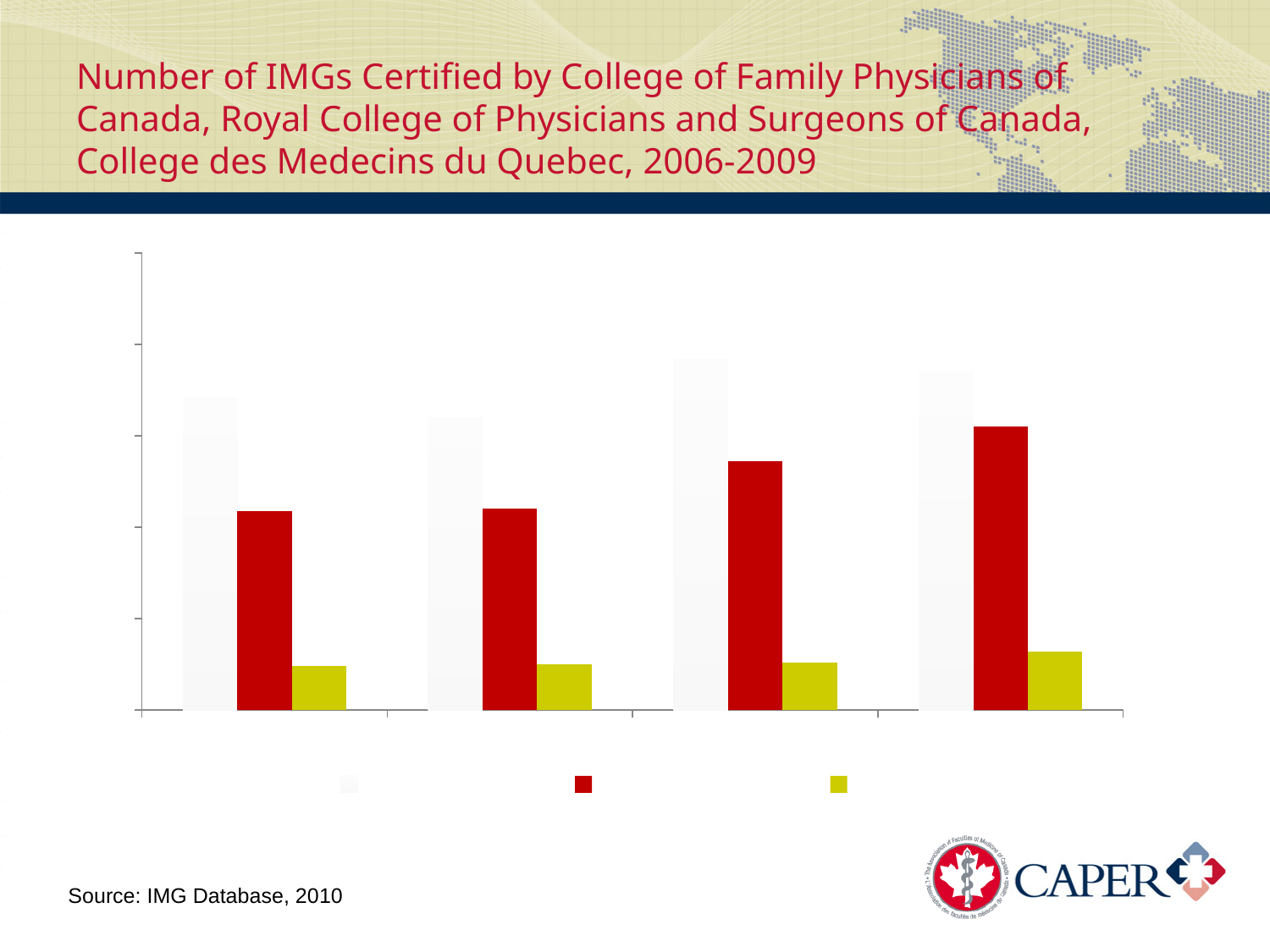
Which colour of bar is the shortest in every group? yellow In which group of bars, counting from the left, is the red bar the tallest? fourth In the fourth group from the left, which bar is taller: the light-coloured bar or the red bar? the light-coloured bar In which group of bars, counting from the left, is the light-coloured bar the tallest? third Do the red bars rise or fall from left to right across the groups? rise How many groups of bars are plotted along the x axis? 4 How many series does the legend list? 3 What source is cited at the bottom of the slide? IMG Database, 2010 In the first group from the left, which bar is taller: the red bar or the yellow bar? the red bar What kind of chart is shown on the slide? bar chart What colours are the three series in the chart? white (light), red and yellow